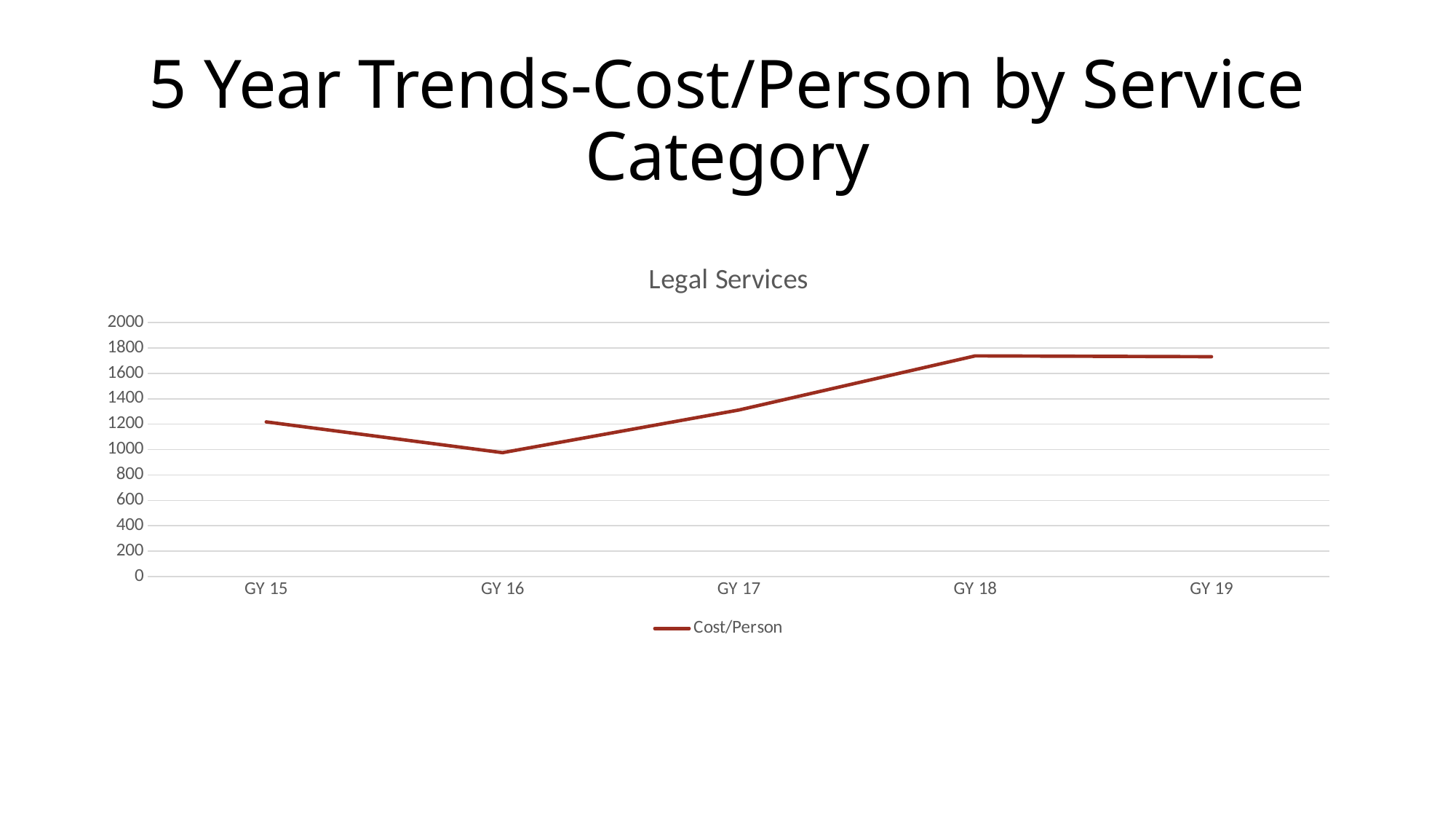
Is the Cost/Person for GY 18 greater or less than 1600? greater Is the Cost/Person for GY 15 greater or less than 1000? greater How many series does the legend list? 1 What is the title of the chart? Legal Services Which has the larger Cost/Person, GY 16 or GY 17? GY 17 How many years are plotted on the x axis? 5 Is the Cost/Person for GY 16 greater or less than 1200? less What kind of chart is shown on the slide? line chart Which year has the lowest Cost/Person? GY 16 Does the Cost/Person rise or fall from GY 16 to GY 18? rise What is the name of the series shown in the legend? Cost/Person